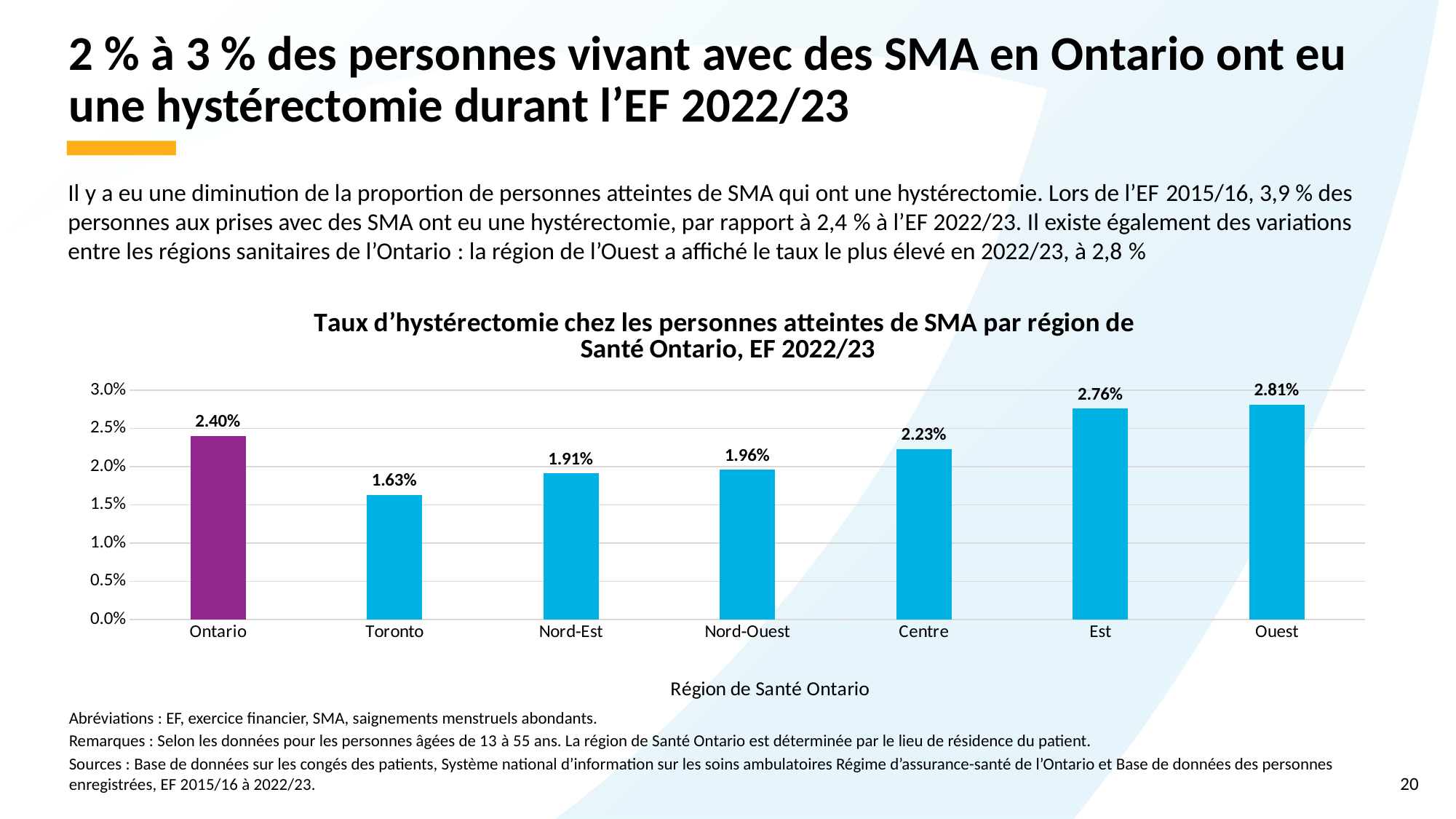
What kind of chart is shown on the slide? Bar chart What is the value shown for Nord-Ouest? 1.96% What is the difference between the values for Ouest and Toronto? 1.18% Which region has the highest hysterectomy rate? Ouest What is the hysterectomy rate shown for Ontario? 2.40% How many bars are shown in the chart? 7 Which bar is shown in a different colour (purple) from the others? Ontario Which has a higher value, Centre or Nord-Ouest? Centre What is the difference between the values for Centre and Nord-Est? 0.32% What is the value shown for Est? 2.76% What is the value shown for Toronto? 1.63% Which region has the lowest hysterectomy rate? Toronto